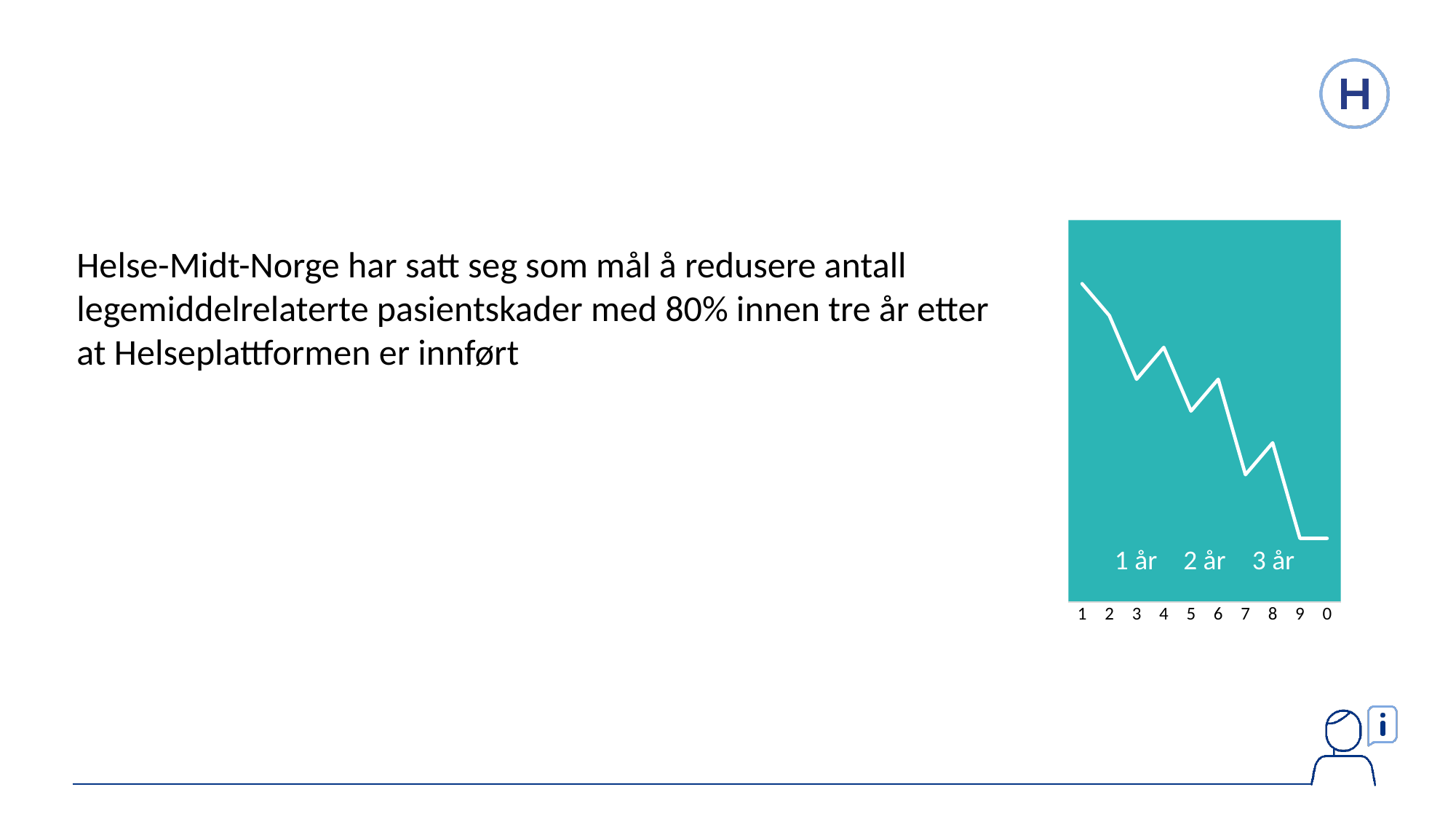
At which x-axis label is the line at its highest value? 1 How many points are labelled on the x axis of the chart? 10 Do the values in the chart rise or fall along the x axis? fall Which has the higher value in the chart, x-axis point 4 or x-axis point 6? 4 Which has the lower value in the chart, x-axis point 2 or x-axis point 8? 8 What colour is the background of the chart? teal Which has the higher value in the chart, x-axis point 1 or x-axis point 0? 1 What three time labels are printed inside the chart area? 1 år, 2 år, 3 år What kind of chart is shown on the slide? line chart